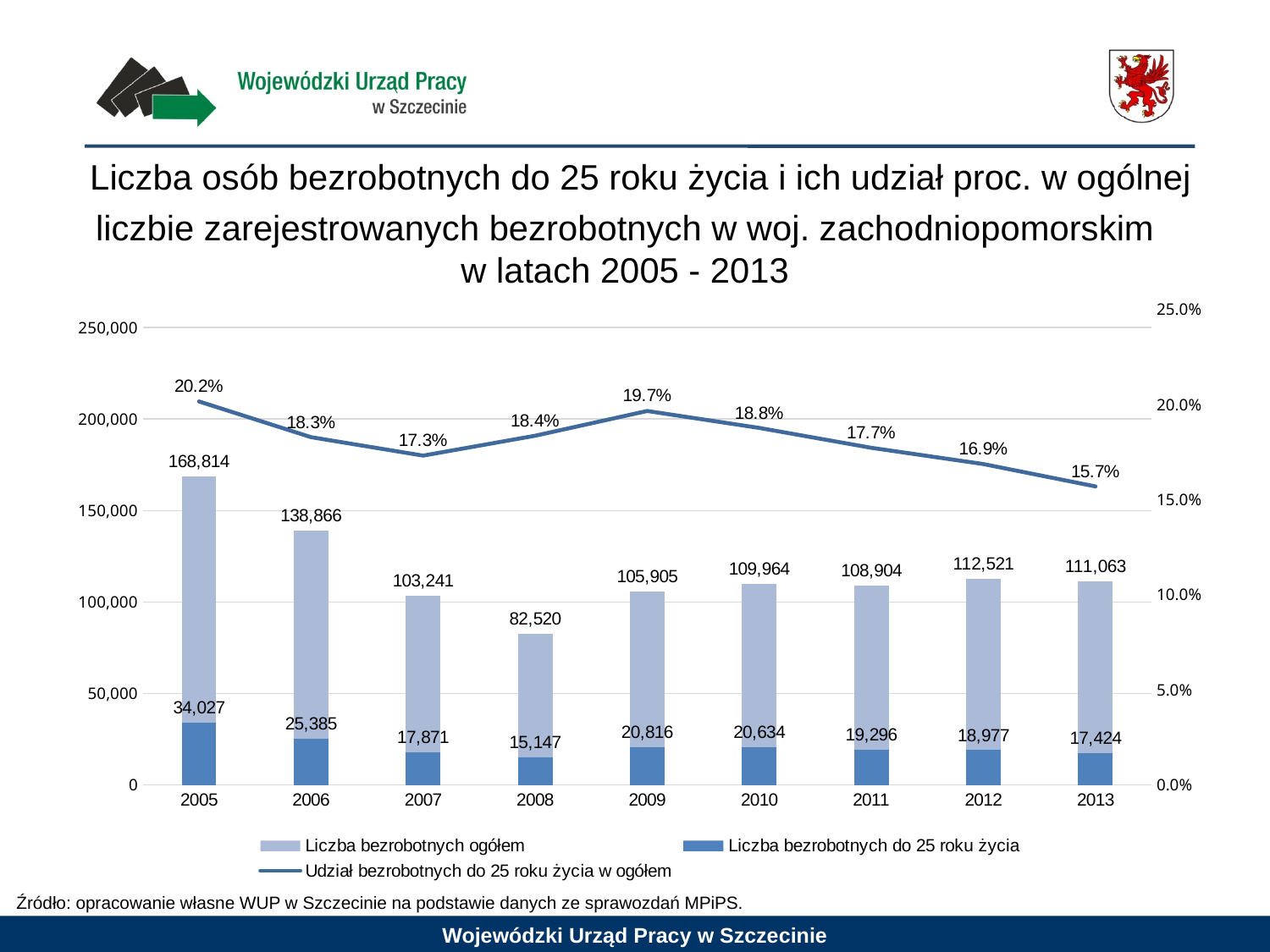
Did the share of unemployed under 25 rise or fall between 2009 and 2013? Fall By how much did the number of unemployed under 25 fall between 2005 and 2006? 8,642 In which year was the share of unemployed under 25 the highest? 2005 What was the share of unemployed under 25 in the total (Udział bezrobotnych do 25 roku życia w ogółem) in 2013? 15.7% How many series does the legend list? 3 What kind of chart is shown on the slide? Combined bar and line chart What was the number of unemployed under 25 (Liczba bezrobotnych do 25 roku życia) in 2009? 20,816 How many years are shown on the x axis of the chart? 9 What is the difference between the total number of registered unemployed in 2012 and in 2013? 1,458 What was the total number of registered unemployed (Liczba bezrobotnych ogółem) in 2005? 168,814 Which year had a higher share of unemployed under 25: 2009 or 2010? 2009 In which year was the total number of registered unemployed the lowest? 2008